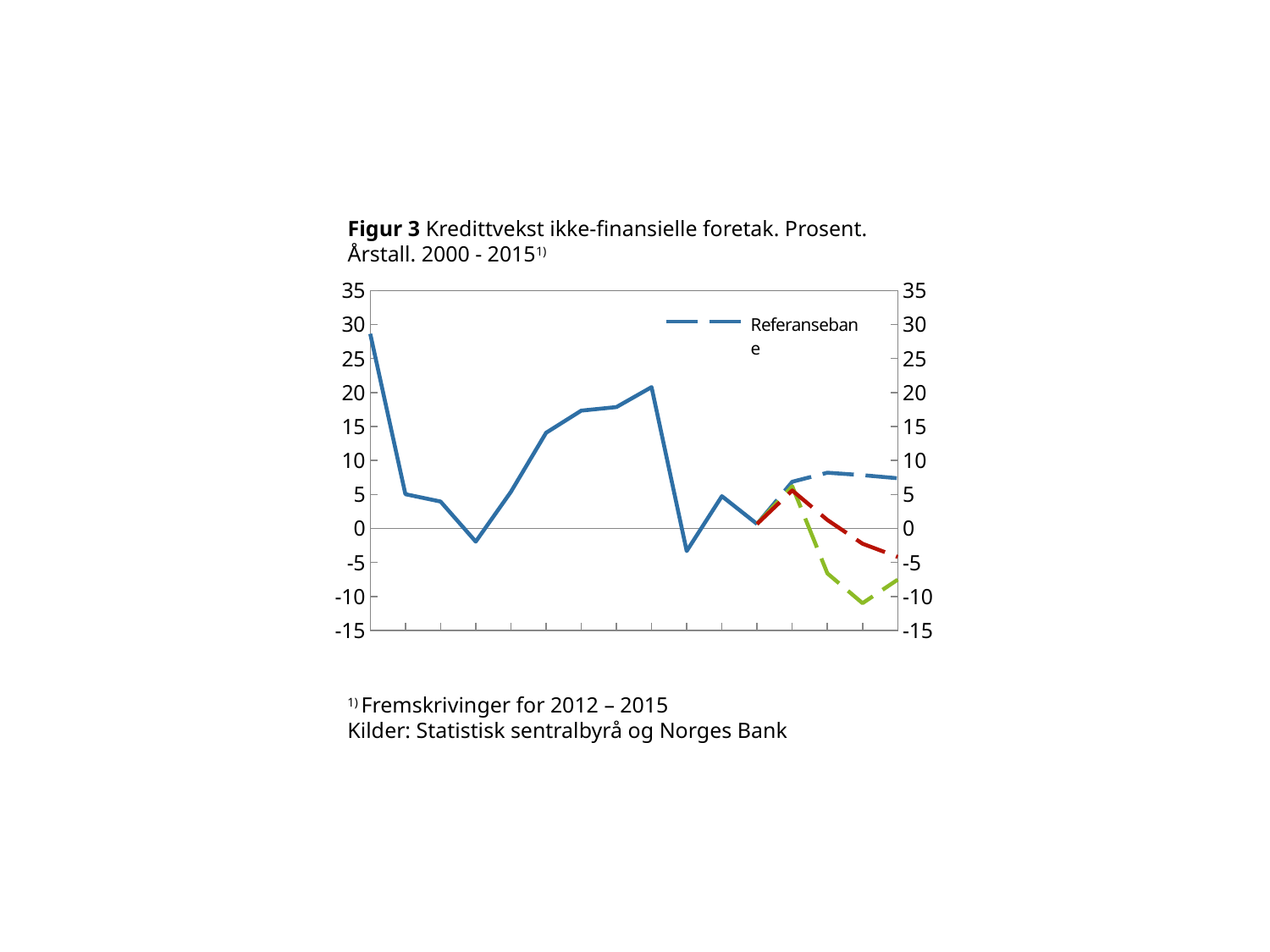
Is the value at the first point of the solid line in Figur 3 greater or less than 25? greater Which of the three dashed lines in Figur 3 ends at the highest value? the blue dashed line (Referansebane) How many series does the legend of Figur 3 list? 1 What is the highest value shown on the vertical axis of Figur 3? 35 What kind of chart is shown in Figur 3? line chart Which of the three dashed lines in Figur 3 reaches the lowest value? the green dashed line Is the final value of the blue dashed line (Referansebane) in Figur 3 greater or less than 5? greater Does the solid line in Figur 3 rise or fall between its first and second points? fall What is the legend entry shown in Figur 3? Referansebane Is the final value of the red dashed line in Figur 3 greater or less than 0? less At the right end of Figur 3, is the blue dashed line or the green dashed line higher? the blue dashed line